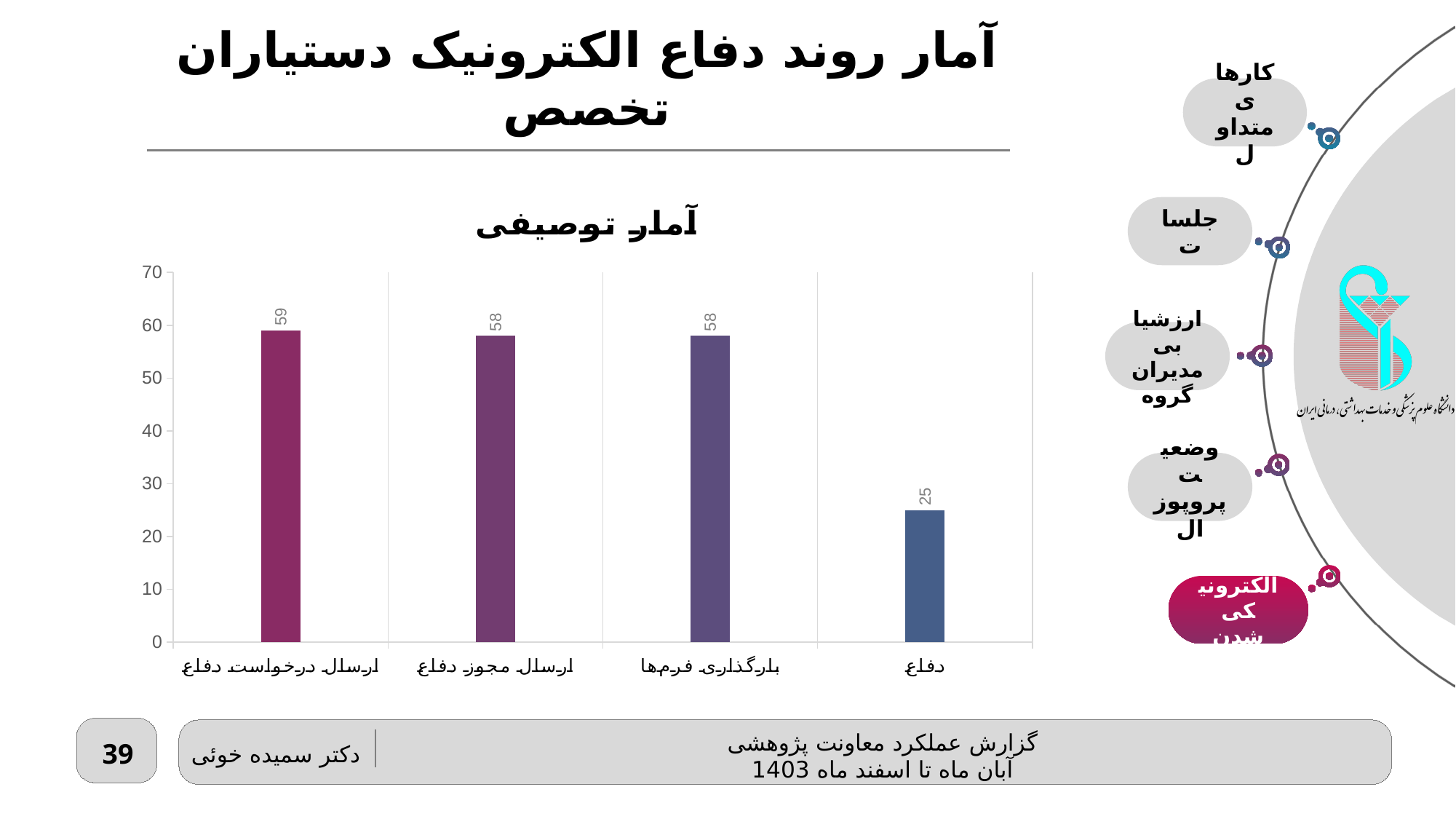
Which category has the highest value? ارسال درخواست دفاع What is the value for ارسال درخواست دفاع? 59 What is the value for دفاع? 25 Which is larger, the value for بارگذاری فرم‌ها or the value for دفاع? بارگذاری فرم‌ها How many categories are shown on the x axis? 4 What is the difference between the values for ارسال درخواست دفاع and دفاع? 34 Is the value for دفاع greater or less than 30? less What type of chart is shown on the slide? bar chart What is the title of the chart? آمار توصیفی Which category has the lowest value? دفاع What is the value for ارسال مجوز دفاع? 58 What is the value for بارگذاری فرم‌ها? 58